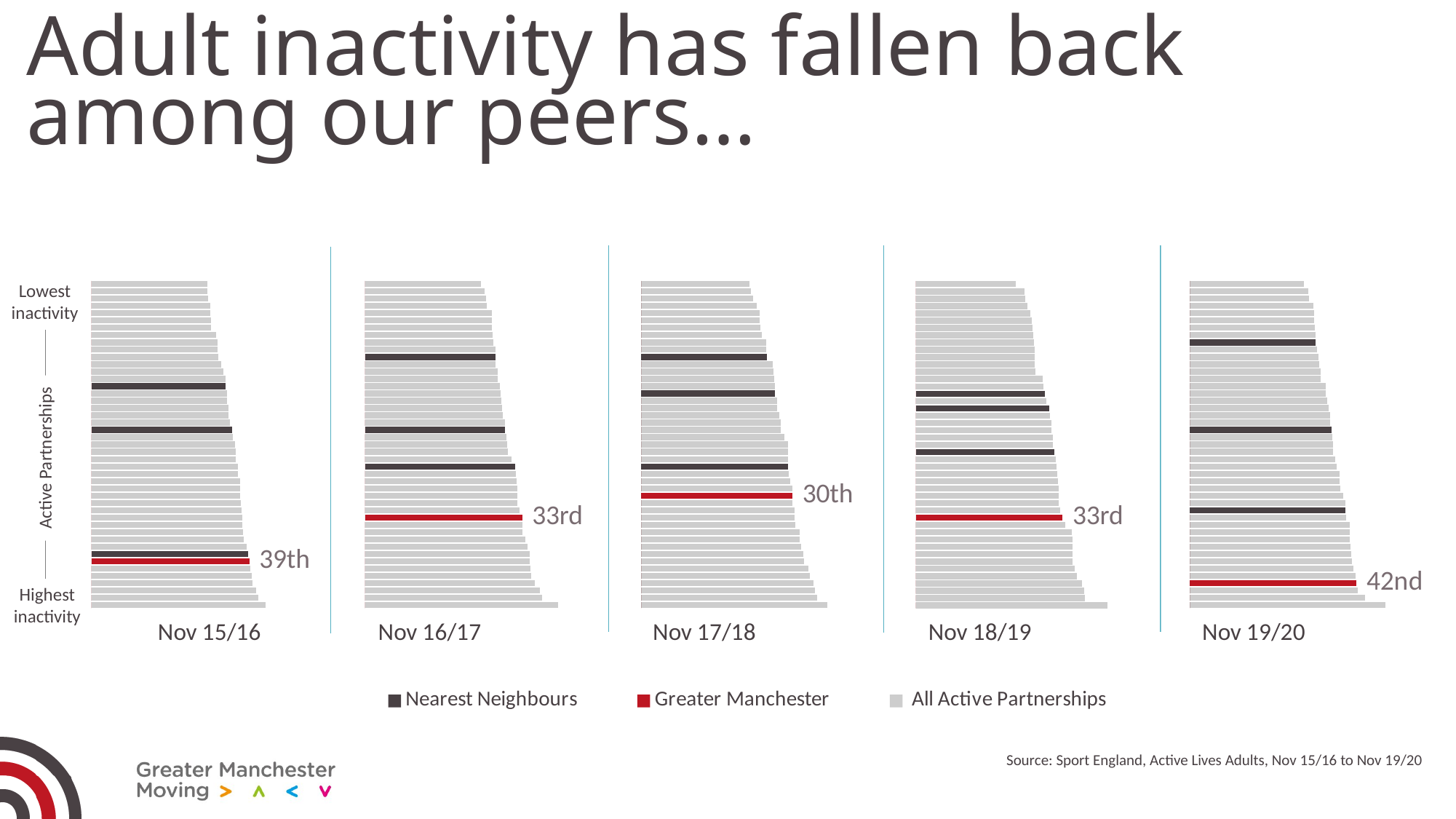
What rank is shown for Greater Manchester in the Nov 15/16 chart? 39th What rank is shown for Greater Manchester in the Nov 19/20 chart? 42nd How many time periods are shown across the charts on the slide? 5 What rank is shown for Greater Manchester in the Nov 17/18 chart? 30th In which period does Greater Manchester have its worst (highest-numbered) rank? Nov 19/20 What rank is shown for Greater Manchester in the Nov 16/17 chart? 33rd In which period does Greater Manchester have its best (lowest-numbered) rank? Nov 17/18 What rank is shown for Greater Manchester in the Nov 18/19 chart? 33rd How many series does the legend list? 3 What kind of chart is used for each time period on the slide? Bar chart By how many places did Greater Manchester's rank change between Nov 18/19 (33rd) and Nov 19/20 (42nd)? 9 By how many places did Greater Manchester's rank change between Nov 15/16 (39th) and Nov 16/17 (33rd)? 6